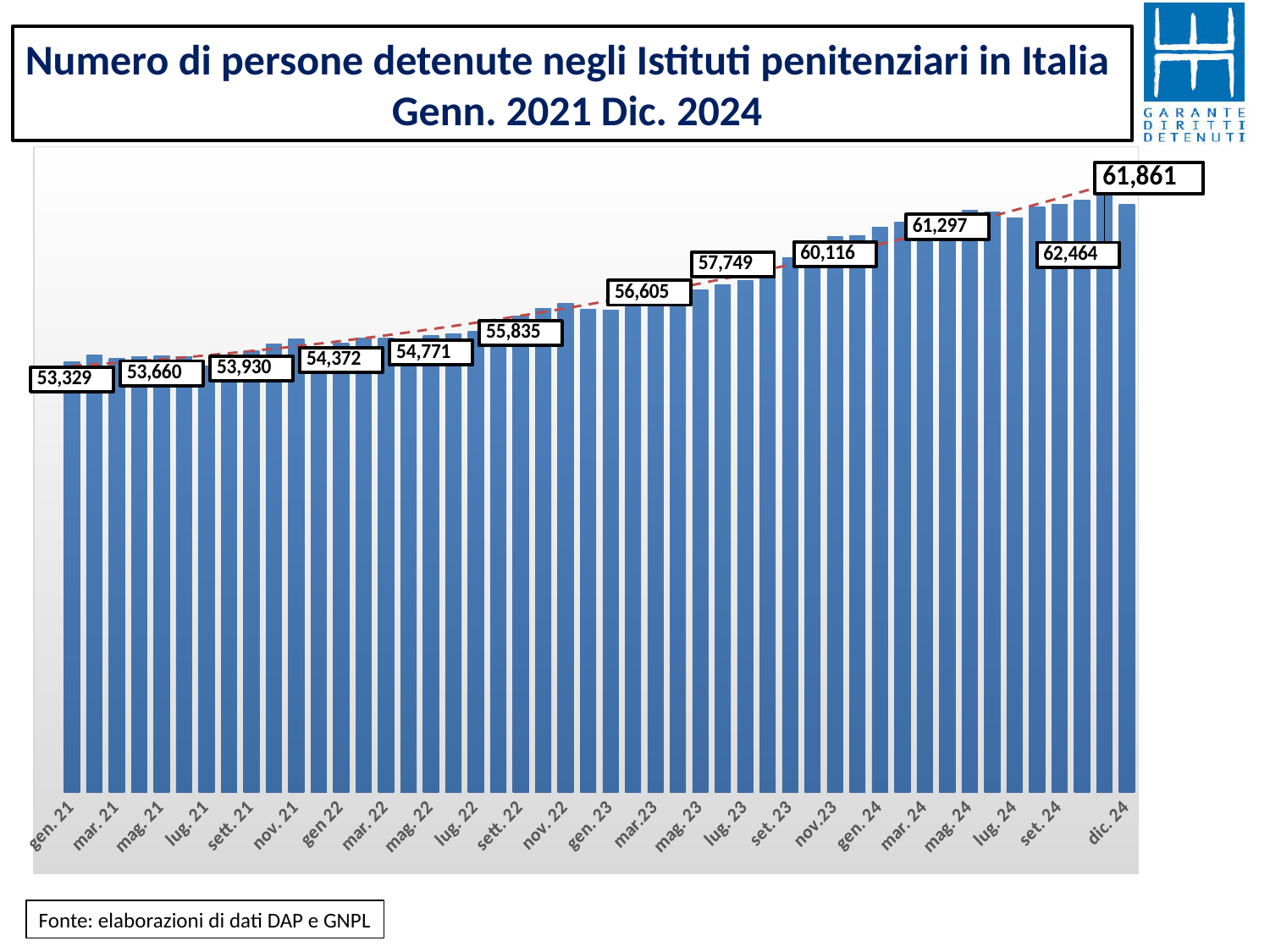
Do the values generally rise or fall from gen. 21 to dic. 24? rise What is the title of the chart? Numero di persone detenute negli Istituti penitenziari in Italia Genn. 2021 Dic. 2024 What kind of chart is shown on the slide? bar chart What is the highest value printed as a data label on the chart? 62,464 What is the number of detained persons shown for dic. 24? 61,861 Which is larger, the value for gen. 21 or the value for dic. 24? dic. 24 What is the lowest value printed as a data label on the chart? 53,329 What source is cited below the chart? Fonte: elaborazioni di dati DAP e GNPL What is the number of detained persons shown for gen. 21? 53,329 How many data labels with values are printed on the chart? 12 What is the difference between the value for dic. 24 (61,861) and the value for gen. 21 (53,329)? 8,532